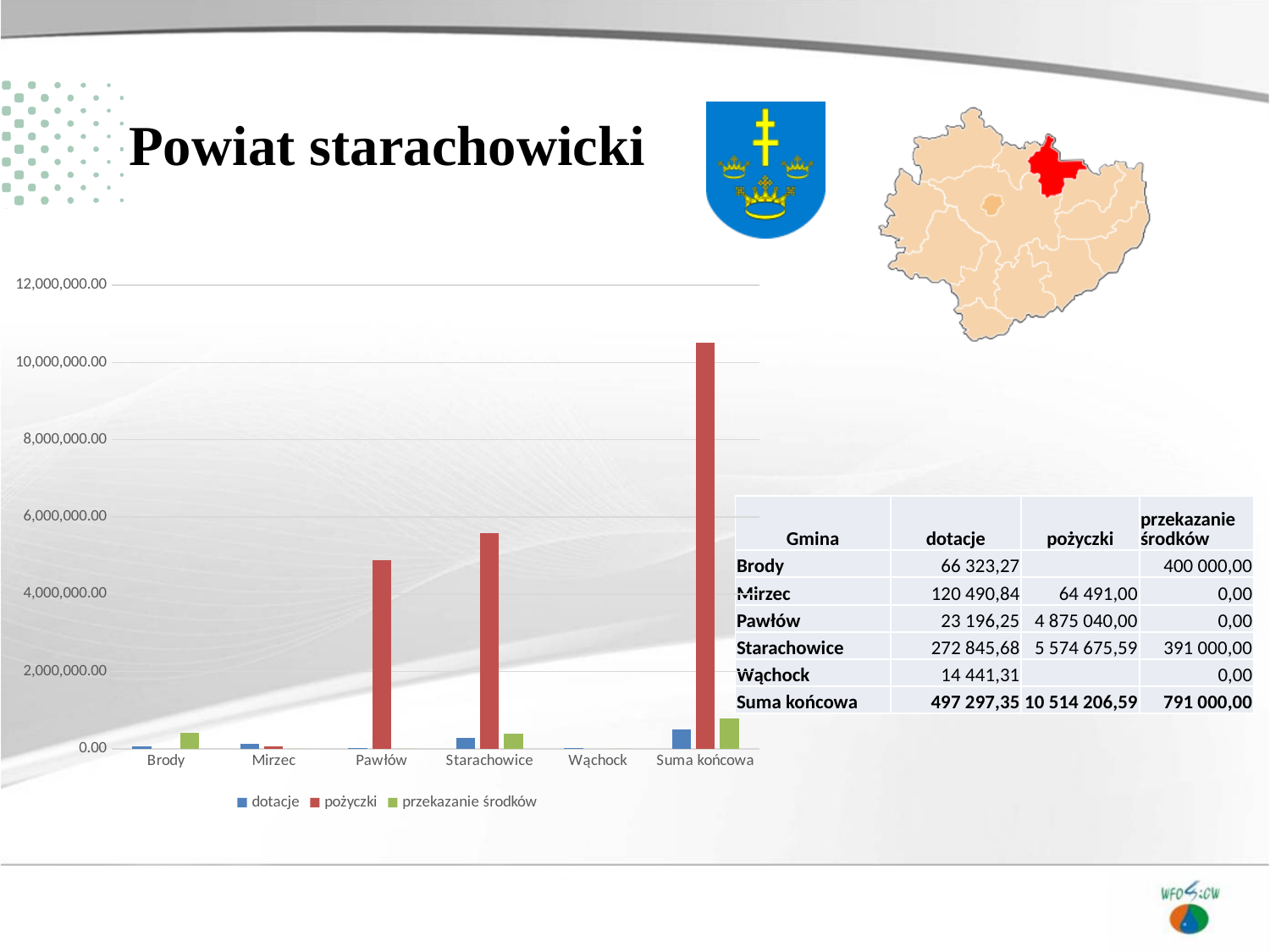
Which has the larger pożyczki bar, Starachowice or Pawłów? Starachowice According to the table on the slide, what is the pożyczki value for Starachowice? 5 574 675,59 According to the table on the slide, what is the dotacje value for Suma końcowa? 497 297,35 What kind of chart is shown on the slide? bar chart Which category has the tallest pożyczki bar? Suma końcowa Is the pożyczki value for Suma końcowa greater or less than 10,000,000.00? greater How many series does the chart legend list? 3 How many categories are shown along the x axis of the chart? 6 Is the pożyczki value for Starachowice greater or less than 6,000,000.00? less According to the table on the slide, what is the przekazanie środków value for Brody? 400 000,00 What are the three series names listed in the chart legend? dotacje, pożyczki, przekazanie środków Is the pożyczki value for Pawłów greater or less than 4,000,000.00? greater